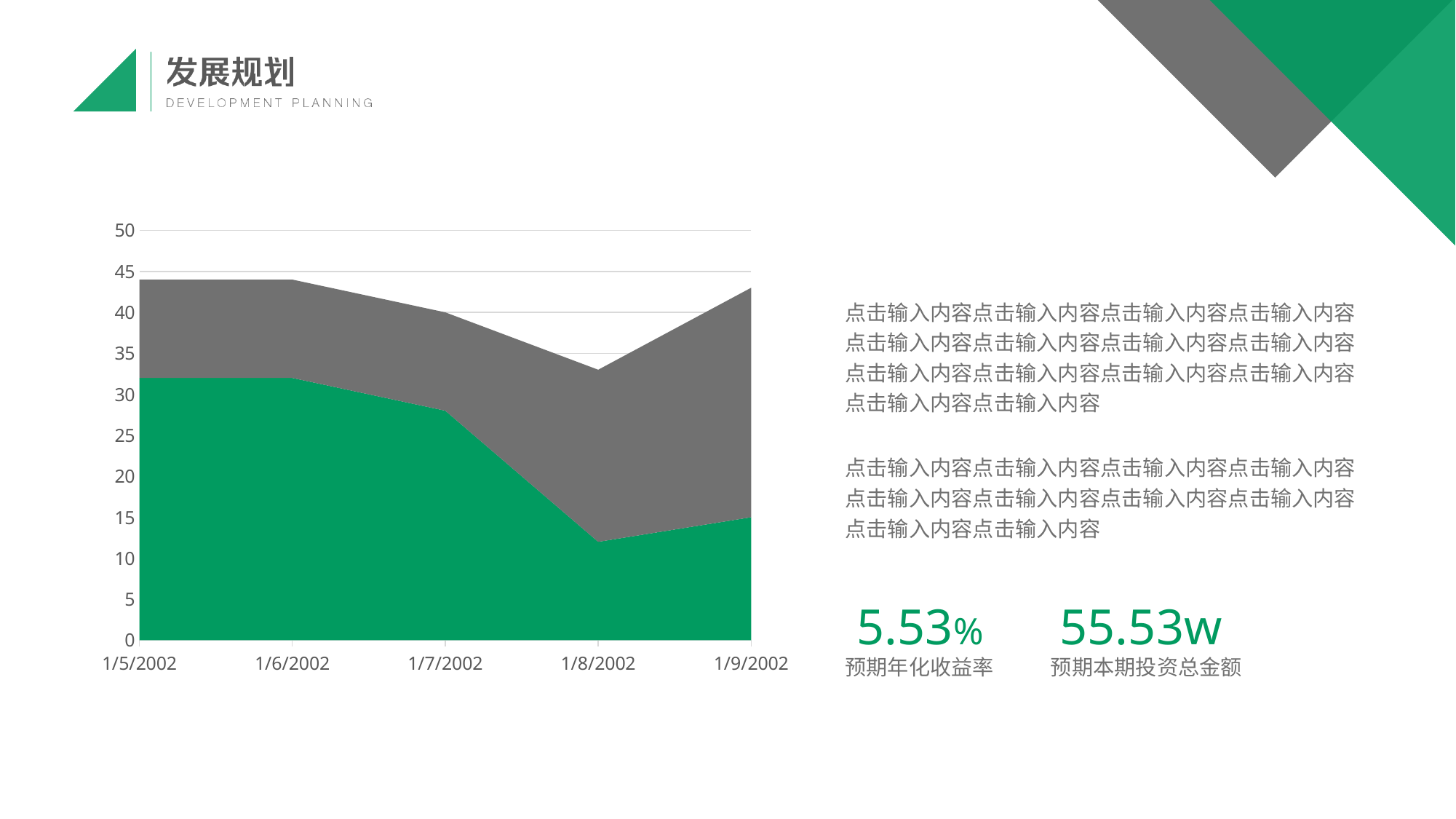
How many stacked areas (series) are plotted in the chart? 2 Is the value of the green series at 1/7/2002 greater or less than 25? greater At which date is the green series at its lowest? 1/8/2002 Which is larger for the green series: the value at 1/7/2002 or at 1/9/2002? 1/7/2002 Is the value of the green series at 1/5/2002 greater or less than 30? greater Is the value of the green series at 1/8/2002 greater or less than 15? less How many dates are shown on the x axis of the chart? 5 What kind of chart is shown on the slide? area chart At which date is the total height of the stacked areas lowest? 1/8/2002 Does the green series rise or fall from 1/5/2002 to 1/8/2002? fall